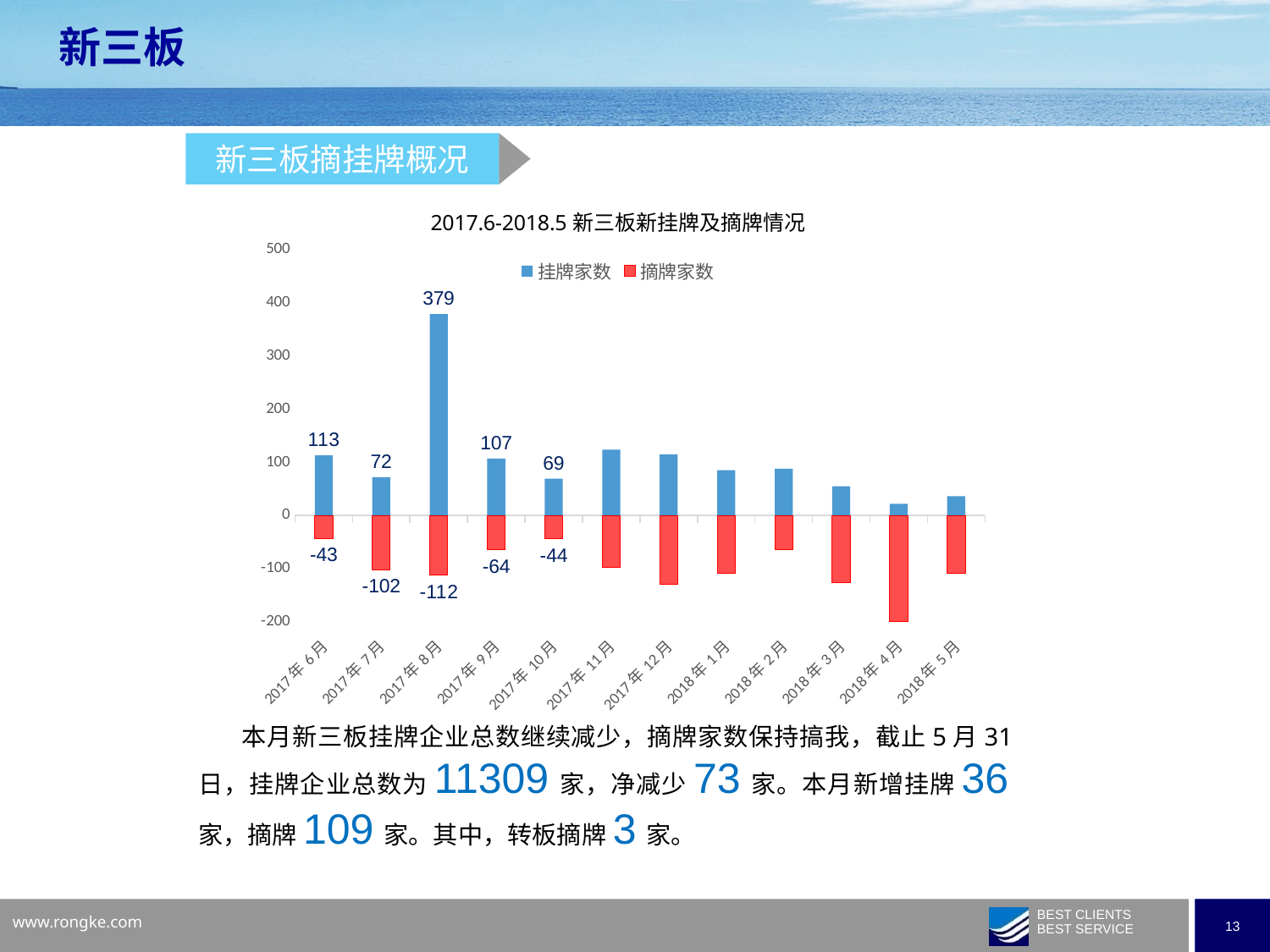
How many series does the chart legend list? 2 Which month has the highest 挂牌家数? 2017年8月 What is the 挂牌家数 value for 2017年8月? 379 What is the 摘牌家数 value for 2017年7月? -102 Which month has the lowest 挂牌家数? 2018年4月 What is the 挂牌家数 value for 2017年10月? 69 Is the 挂牌家数 value for 2017年11月 greater or less than 100? greater Is the 摘牌家数 value for 2018年4月 greater or less than -100? less What is the difference between the 挂牌家数 values for 2017年6月 and 2017年9月? 6 Which month has the lowest (most negative) 摘牌家数 value? 2018年4月 Which is larger, the 挂牌家数 for 2017年6月 or for 2017年7月? 2017年6月 How many months are shown on the x axis of the chart? 12